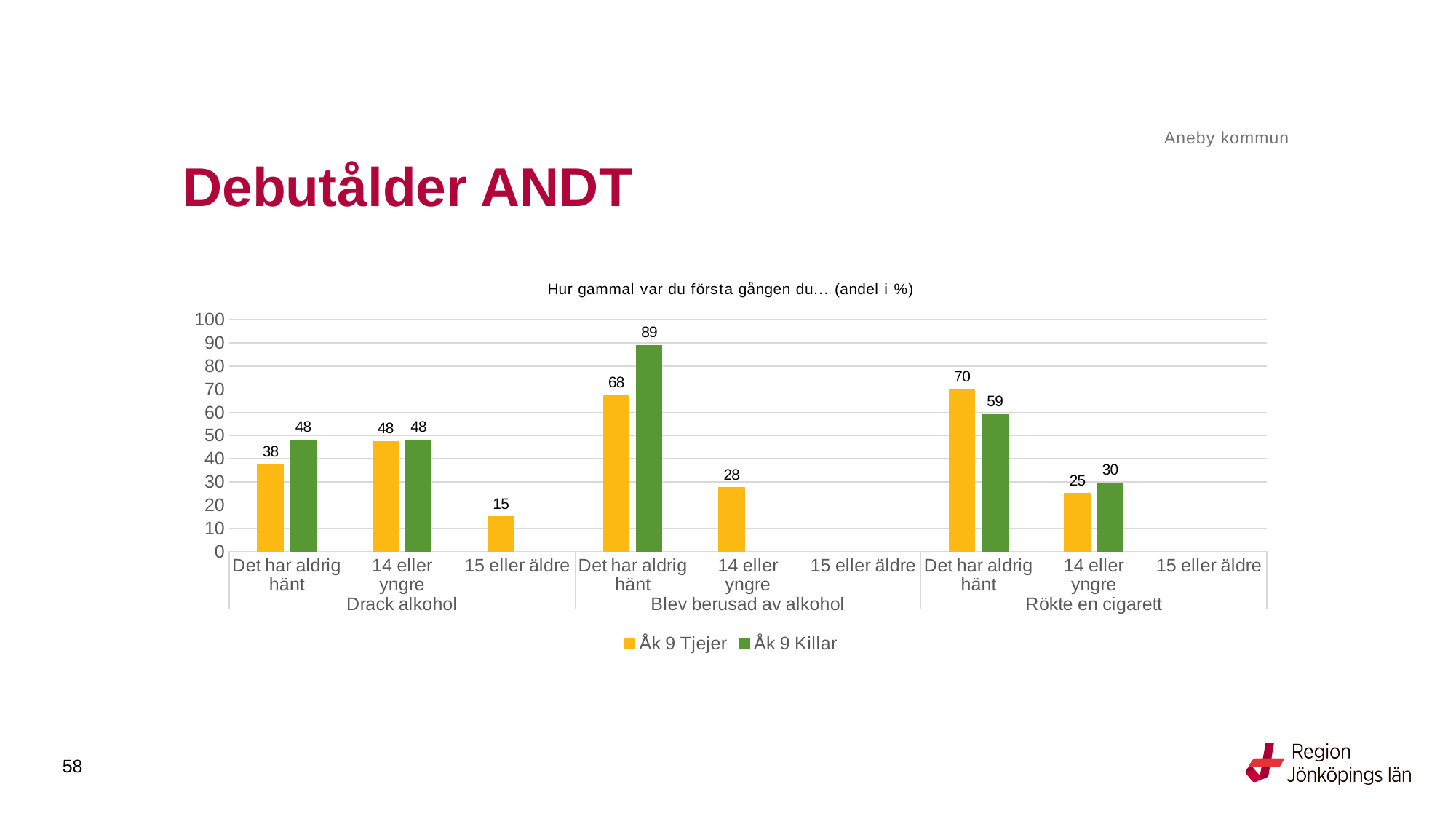
What is the difference between Åk 9 Killar and Åk 9 Tjejer for 'Det har aldrig hänt' under 'Blev berusad av alkohol'? 21 What is the difference between Åk 9 Tjejer and Åk 9 Killar for 'Det har aldrig hänt' under 'Rökte en cigarett'? 11 For 'Det har aldrig hänt' under 'Rökte en cigarett', which series has the larger value, Åk 9 Tjejer or Åk 9 Killar? Åk 9 Tjejer What is the title of the chart? Hur gammal var du första gången du… (andel i %) How many series does the legend list? 2 What is the value for Åk 9 Killar for 'Det har aldrig hänt' under 'Blev berusad av alkohol'? 89 What is the value for Åk 9 Killar for '14 eller yngre' under 'Rökte en cigarett'? 30 What is the value for Åk 9 Tjejer for '15 eller äldre' under 'Drack alkohol'? 15 Which colour represents Åk 9 Killar in the chart? green Which bar has the highest value in the chart? Åk 9 Killar, Det har aldrig hänt (Blev berusad av alkohol) What kind of chart is shown on the slide? bar chart What is the value for Åk 9 Tjejer for 'Det har aldrig hänt' under 'Drack alkohol'? 38